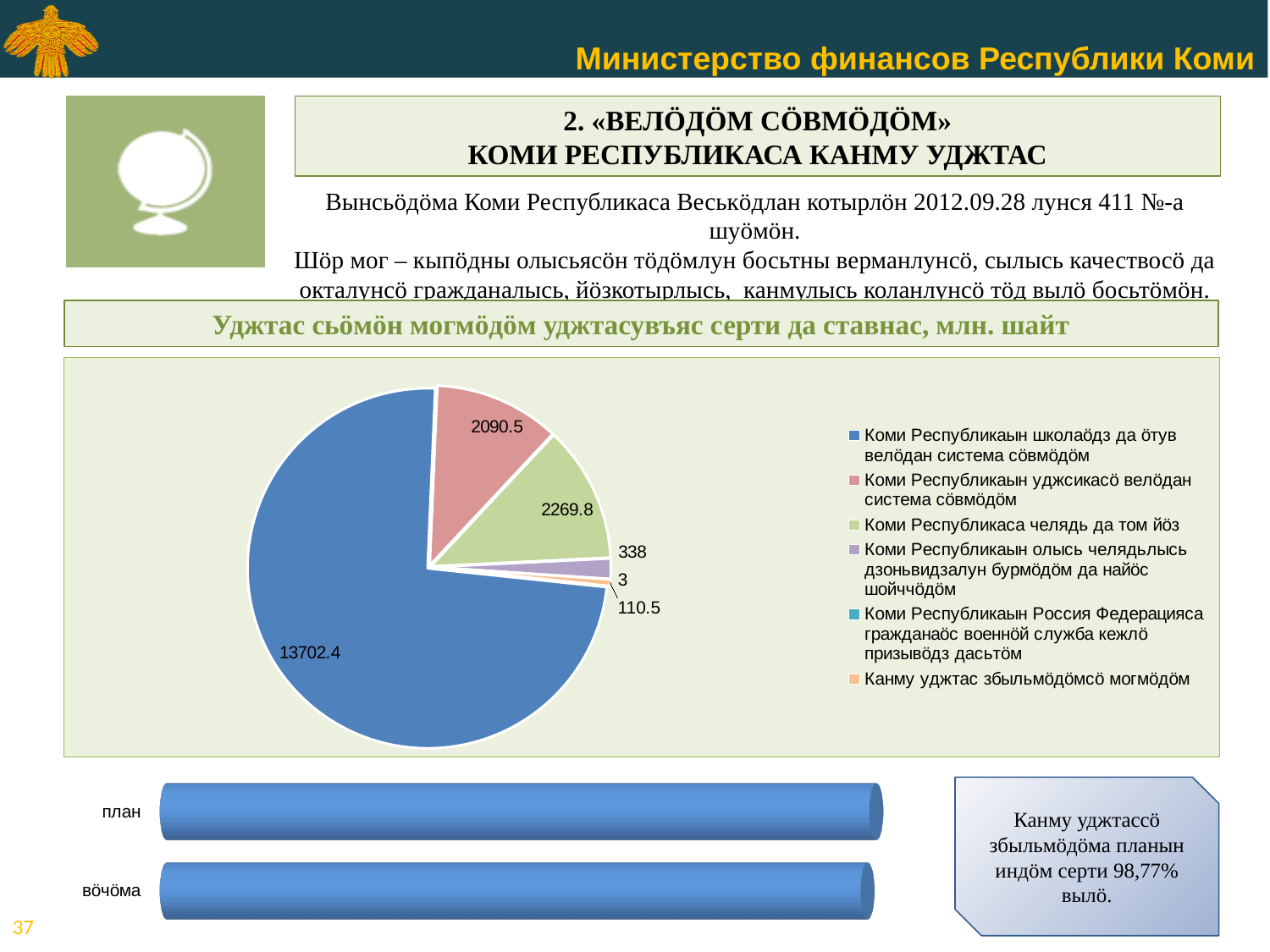
What kind of chart is the chart at the bottom of the slide with the categories «план» and «вöчöма»? bar chart In the pie chart, which is larger: the value for «Коми Республикаса челядь да том йöз» or the value for «Коми Республикаын уджсикасö велöдан система сöвмöдöм»? Коми Республикаса челядь да том йöз In the pie chart, what is the value for «Коми Республикаын уджсикасö велöдан система сöвмöдöм»? 2090.5 How many entries does the legend of the pie chart list? 6 In the pie chart, which category has the smallest value? Коми Республикаын Россия Федерацияса гражданаöс военнöй служба кежлö призывöдз дасьтöм How many bars does the bar chart at the bottom of the slide have? 2 In the pie chart, what is the value for «Коми Республикаса челядь да том йöз»? 2269.8 In the pie chart, what is the value for «Коми Республикаын школаöдз да öтув велöдан система сöвмöдöм»? 13702.4 In the pie chart, which category has the largest value? Коми Республикаын школаöдз да öтув велöдан система сöвмöдöм How many slices does the pie chart have? 6 In the pie chart, what is the value for «Канму уджтас збыльмöдöмсö могмöдöм»? 110.5 In the pie chart, what is the difference between the values 2269.8 and 2090.5? 179.3